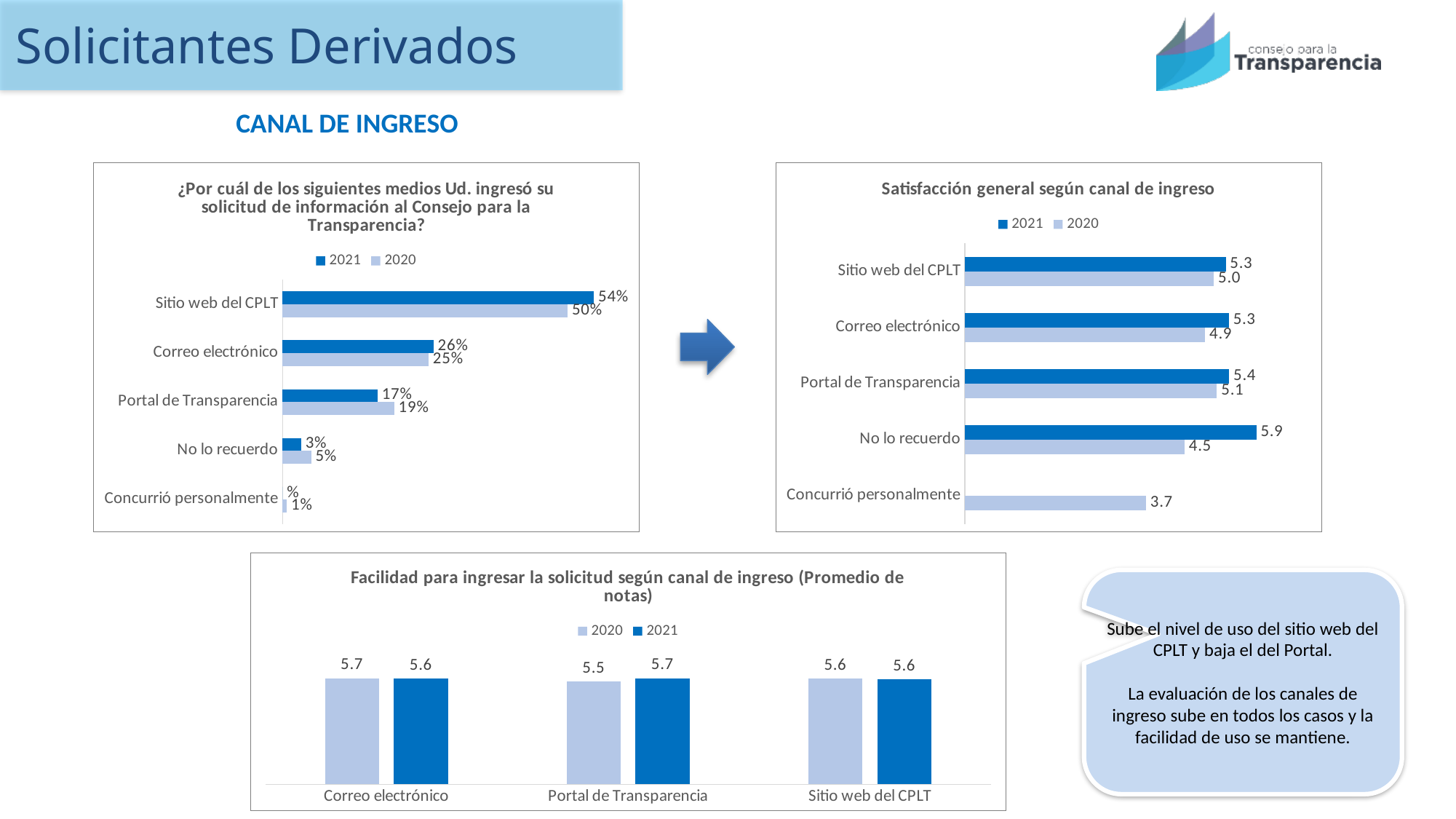
In the top-left chart (¿Por cuál de los siguientes medios Ud. ingresó su solicitud...?), what is the difference between the 2021 and 2020 values for Sitio web del CPLT? 4% In the chart titled 'Facilidad para ingresar la solicitud según canal de ingreso (Promedio de notas)', what is the 2021 value for Portal de Transparencia? 5.7 In the chart titled 'Facilidad para ingresar la solicitud según canal de ingreso (Promedio de notas)', how many series does the legend list? 2 In the top-left chart (¿Por cuál de los siguientes medios Ud. ingresó su solicitud...?), how many categories are shown? 5 In the chart titled 'Satisfacción general según canal de ingreso', what is the 2021 value for No lo recuerdo? 5.9 In the chart titled 'Facilidad para ingresar la solicitud según canal de ingreso (Promedio de notas)', what type of chart is it? bar chart In the top-left chart (¿Por cuál de los siguientes medios Ud. ingresó su solicitud...?), what is the 2020 value for Portal de Transparencia? 19% In the chart titled 'Satisfacción general según canal de ingreso', which category has the lowest 2020 value? Concurrió personalmente In the top-left chart (¿Por cuál de los siguientes medios Ud. ingresó su solicitud...?), what is the 2021 value for Sitio web del CPLT? 54% In the top-left chart (¿Por cuál de los siguientes medios Ud. ingresó su solicitud...?), which category has the highest 2021 value? Sitio web del CPLT In the chart titled 'Satisfacción general según canal de ingreso', what is the 2020 value for Concurrió personalmente? 3.7 In the chart titled 'Satisfacción general según canal de ingreso', is the 2021 value for Portal de Transparencia larger or smaller than the 2020 value? larger